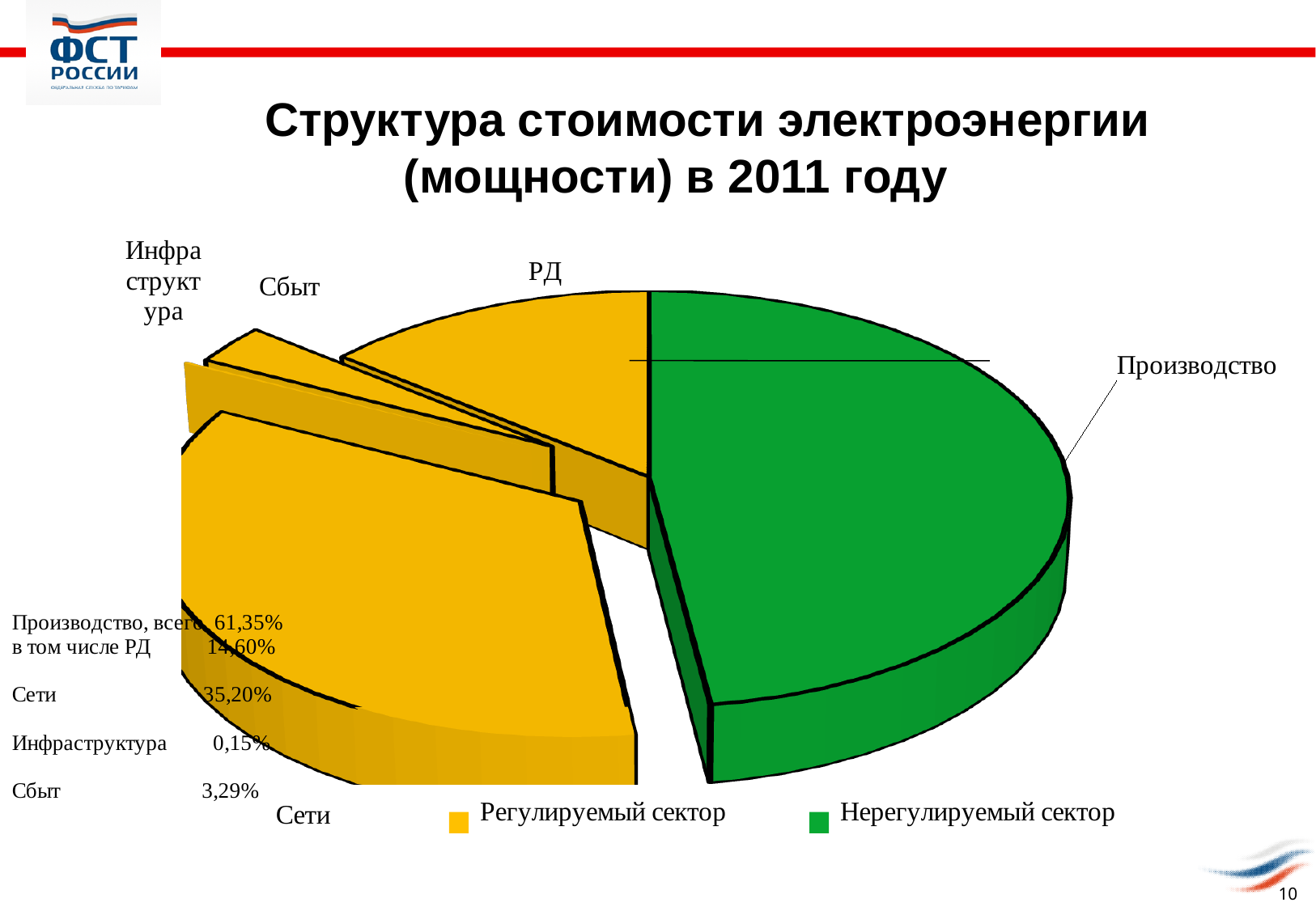
What colour represents Нерегулируемый сектор in the legend? green Which slice of the pie is the smallest? Инфраструктура How many entries does the legend list? 2 What percentage is listed for Инфраструктура? 0,15% What percentage is listed for РД (в том числе РД)? 14,60% What percentage is listed for Сбыт? 3,29% What kind of chart is shown on the slide? pie chart What is the difference between the listed percentages for Сети and Сбыт? 31,91% Which is larger, Сети or Сбыт? Сети Which slice of the pie is the largest? Производство What percentage is listed for Производство, всего? 61,35% What percentage is listed for Сети? 35,20%